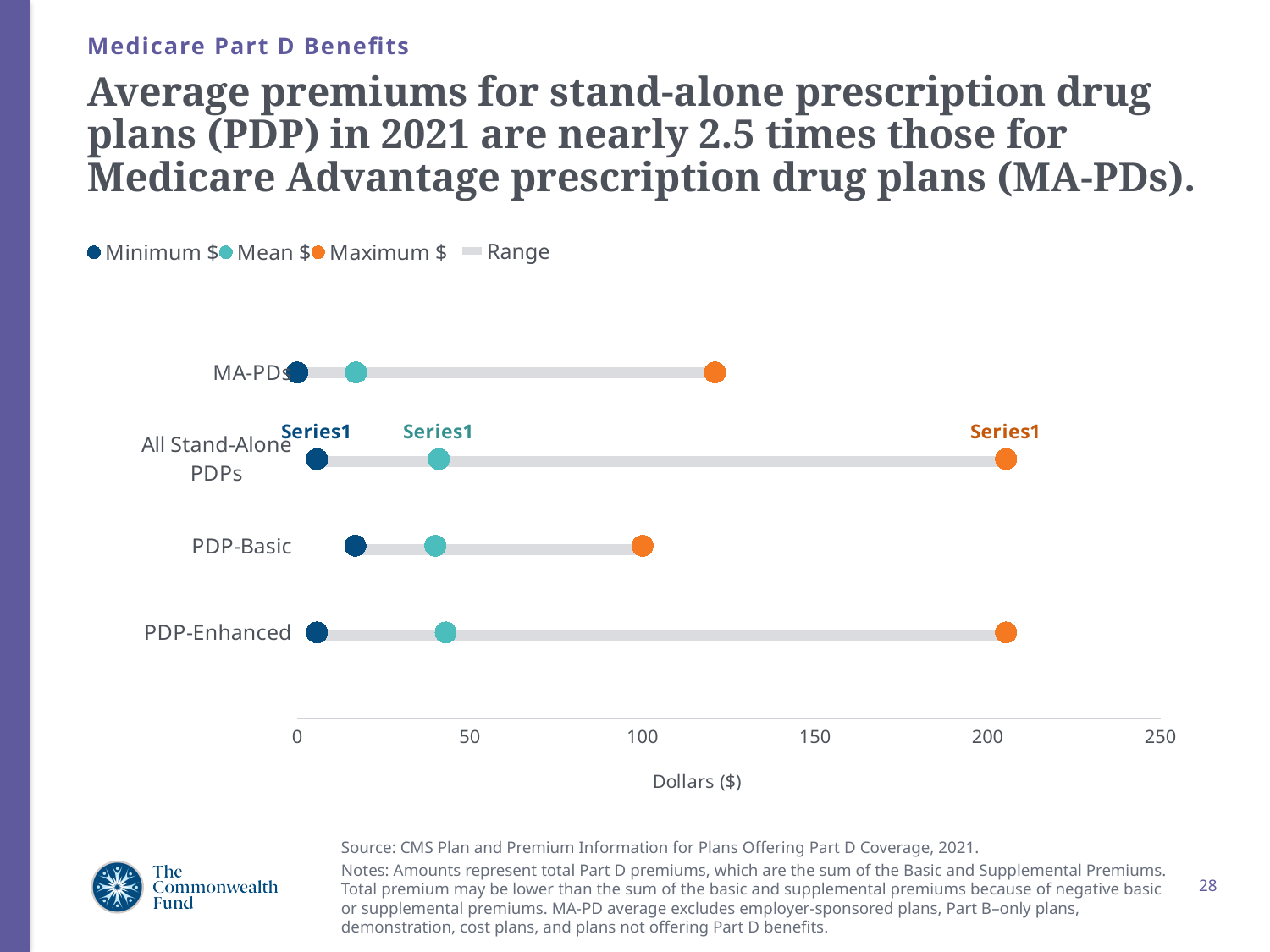
Is the Maximum $ value for PDP-Basic greater or less than 150? less Is the Maximum $ value for MA-PDs greater or less than 150? less Is the Maximum $ value for All Stand-Alone PDPs greater or less than 200? greater How many entries does the chart legend list? 4 What is the title of the chart's x axis? Dollars ($) How many plan categories are shown on the y axis of the chart? 4 Which plan category has the lowest Maximum $ value? PDP-Basic Which has the larger Maximum $ value, PDP-Basic or MA-PDs? MA-PDs Which has the larger Mean $ value, MA-PDs or PDP-Basic? PDP-Basic Which plan category has the lowest Mean $ value? MA-PDs